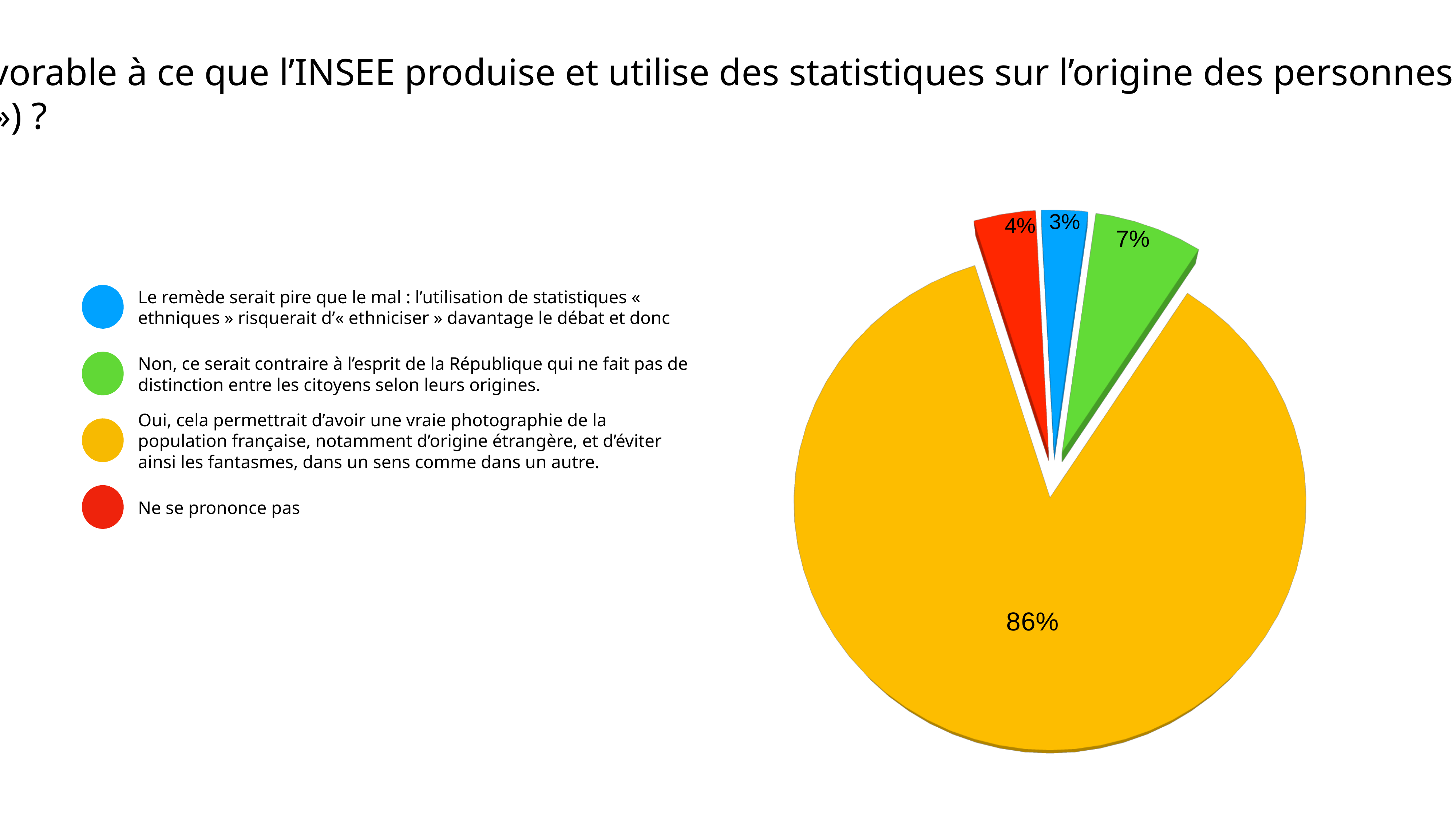
Which is larger: the "Ne se prononce pas" slice or the "Non, ce serait contraire à l'esprit de la République..." slice? Non, ce serait contraire à l'esprit de la République qui ne fait pas de distinction entre les citoyens selon leurs origines. Which category has the smallest slice of the pie? Le remède serait pire que le mal : l'utilisation de statistiques « ethniques » risquerait d'« ethniciser » davantage le débat et donc What is the difference between the "Oui" slice (86%) and the "Non" slice (7%)? 79 percentage points What colour is the slice for "Ne se prononce pas"? Red What share of the pie does the "Ne se prononce pas" slice represent? 4% Which category has the largest slice of the pie? Oui, cela permettrait d'avoir une vraie photographie de la population française, notamment d'origine étrangère, et d'éviter ainsi les fantasmes, dans un sens comme dans un autre. How many slices does the pie chart have? 4 What share of the pie does the "Oui, cela permettrait d'avoir une vraie photographie de la population française..." slice represent? 86% What share of the pie does the "Le remède serait pire que le mal..." slice represent? 3% What colour is the largest slice of the pie? Yellow What kind of chart is shown on the slide? Pie chart